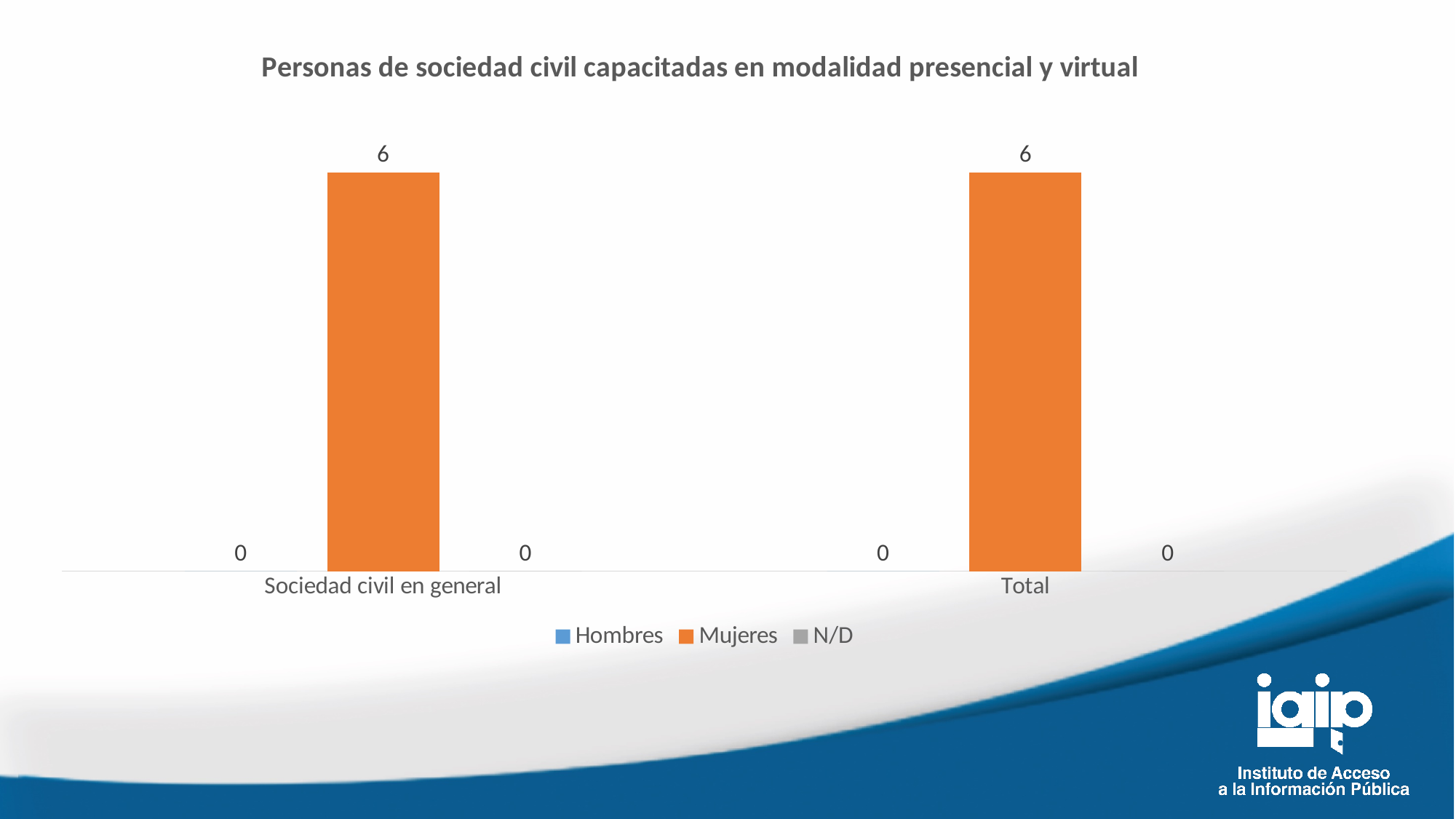
What colour represents the Mujeres series in the chart? Orange What is the value for Hombres in the Total category? 0 Which is larger in the Total category, the value for Mujeres or the value for N/D? Mujeres Which series has the highest value in the Total category? Mujeres What is the value for Mujeres in the Total category? 6 What is the value for N/D in the Sociedad civil en general category? 0 What kind of chart is shown on the slide? Bar chart What is the title of the chart? Personas de sociedad civil capacitadas en modalidad presencial y virtual How many categories are shown on the x axis? 2 What is the value for Mujeres in the Sociedad civil en general category? 6 How many series does the legend list? 3 What is the difference between the Mujeres and Hombres values in the Sociedad civil en general category? 6